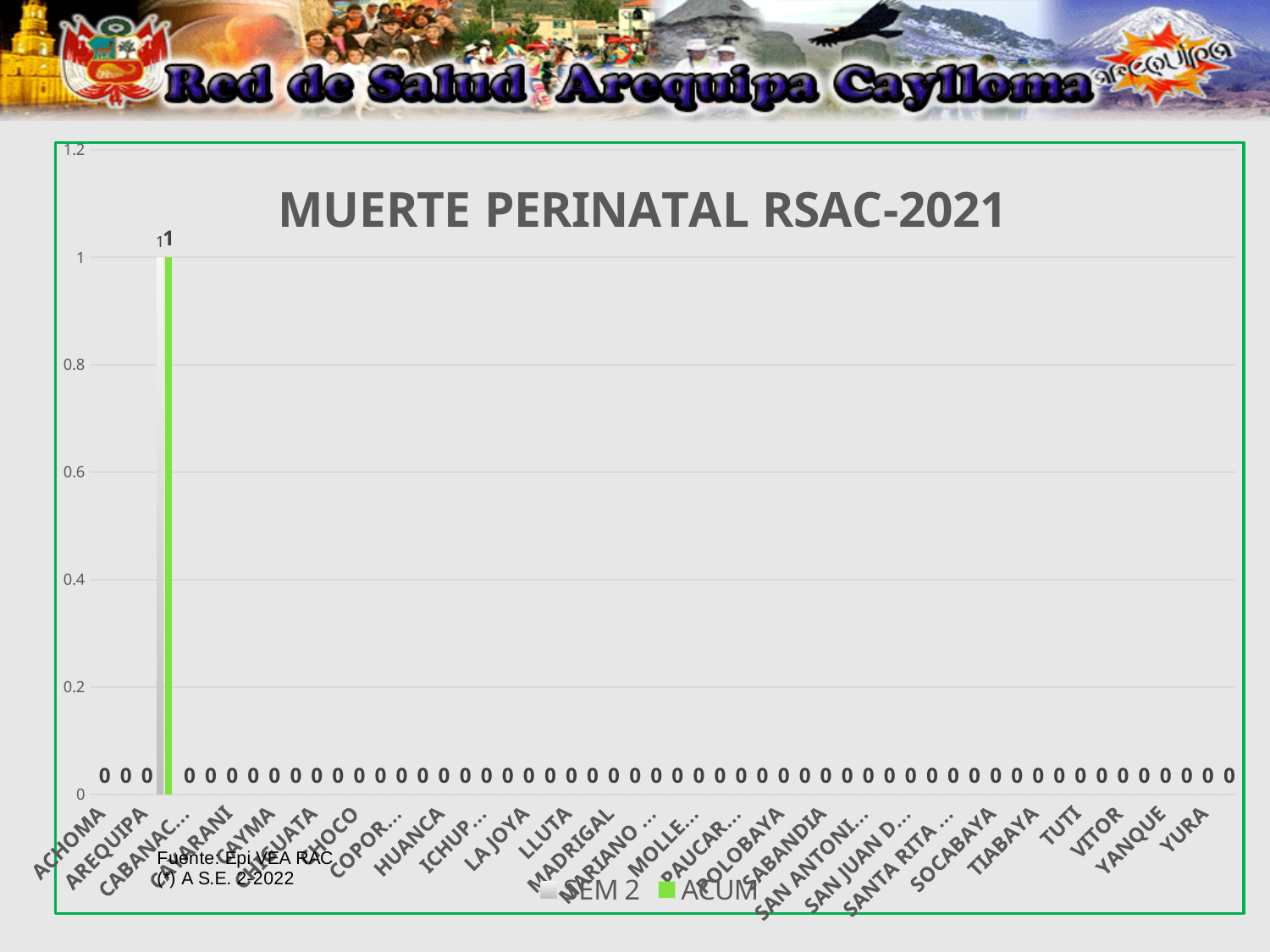
What are the two series named in the legend? SEM 2 and ACUM What is the maximum value shown on the vertical axis? 1.2 What is the ACUM value for ACHOMA? 0 Which is larger, the ACUM value for AREQUIPA or the ACUM value for LA JOYA? They are equal (both 0) What is the ACUM value for SOCABAYA? 0 How many series does the legend list? 2 What kind of chart is shown on the slide? bar chart Is the highest ACUM value in the chart greater or less than 0.8? greater What is the title of the chart? MUERTE PERINATAL RSAC-2021 What is the ACUM value for YURA? 0 What is the highest value plotted in the chart? 1